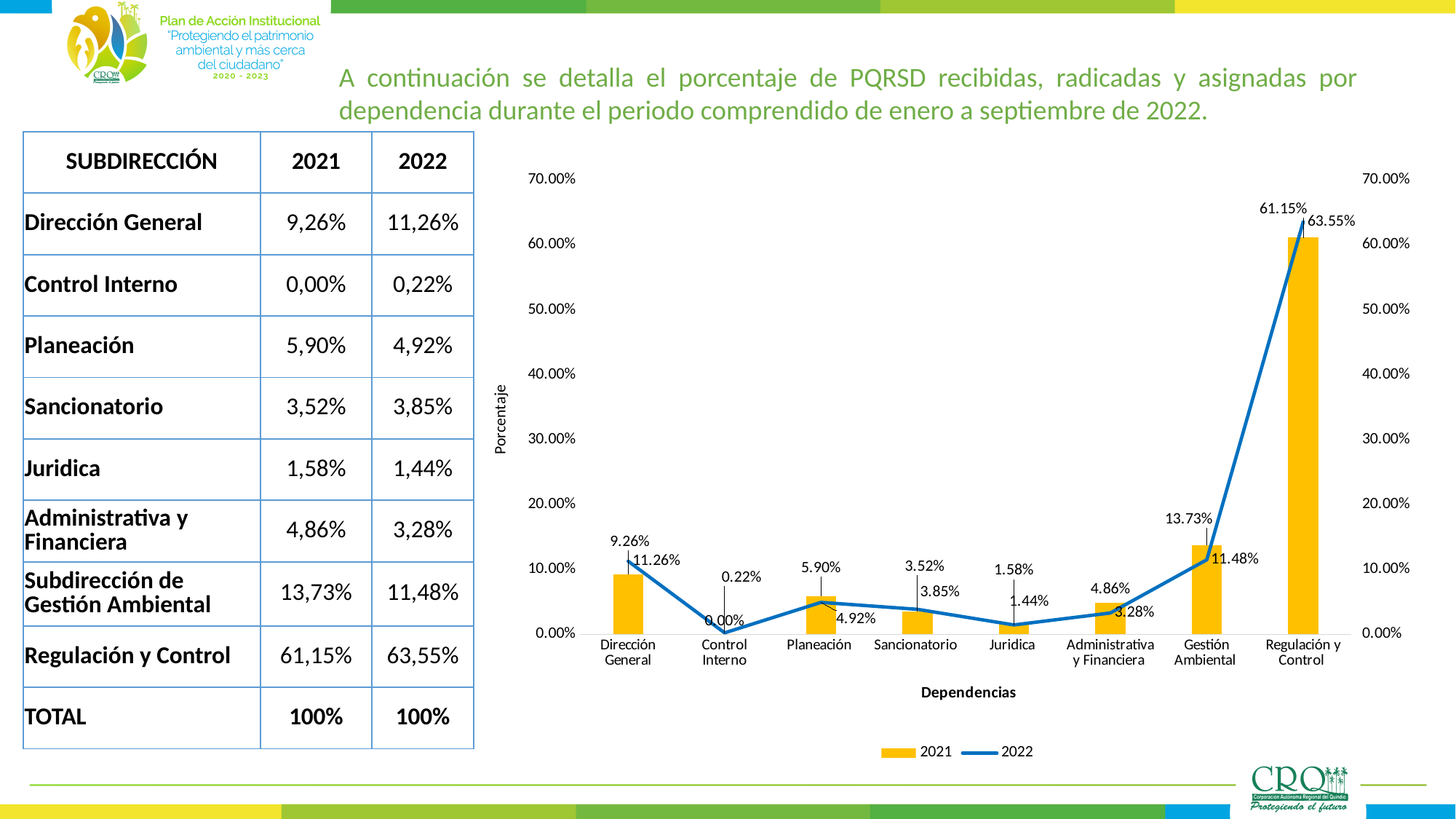
Which is larger for Planeación: the 2021 value or the 2022 value? 2021 What is the 2021 value for Gestión Ambiental in the chart? 13.73% What kind of chart is shown on the slide? Combined bar and line chart What is the label of the x axis of the chart? Dependencias Is the 2021 value for Gestión Ambiental greater or less than 10.00%? greater What is the 2022 value for Dirección General in the chart? 11.26% How many dependencias are shown on the x axis of the chart? 8 What is the 2022 value for Control Interno in the chart? 0.22% How many series does the chart legend list? 2 Which dependencia has the highest 2021 value in the chart? Regulación y Control Which dependencia has the lowest 2021 value in the chart? Control Interno What is the difference between the 2022 and 2021 values for Regulación y Control? 2.40%